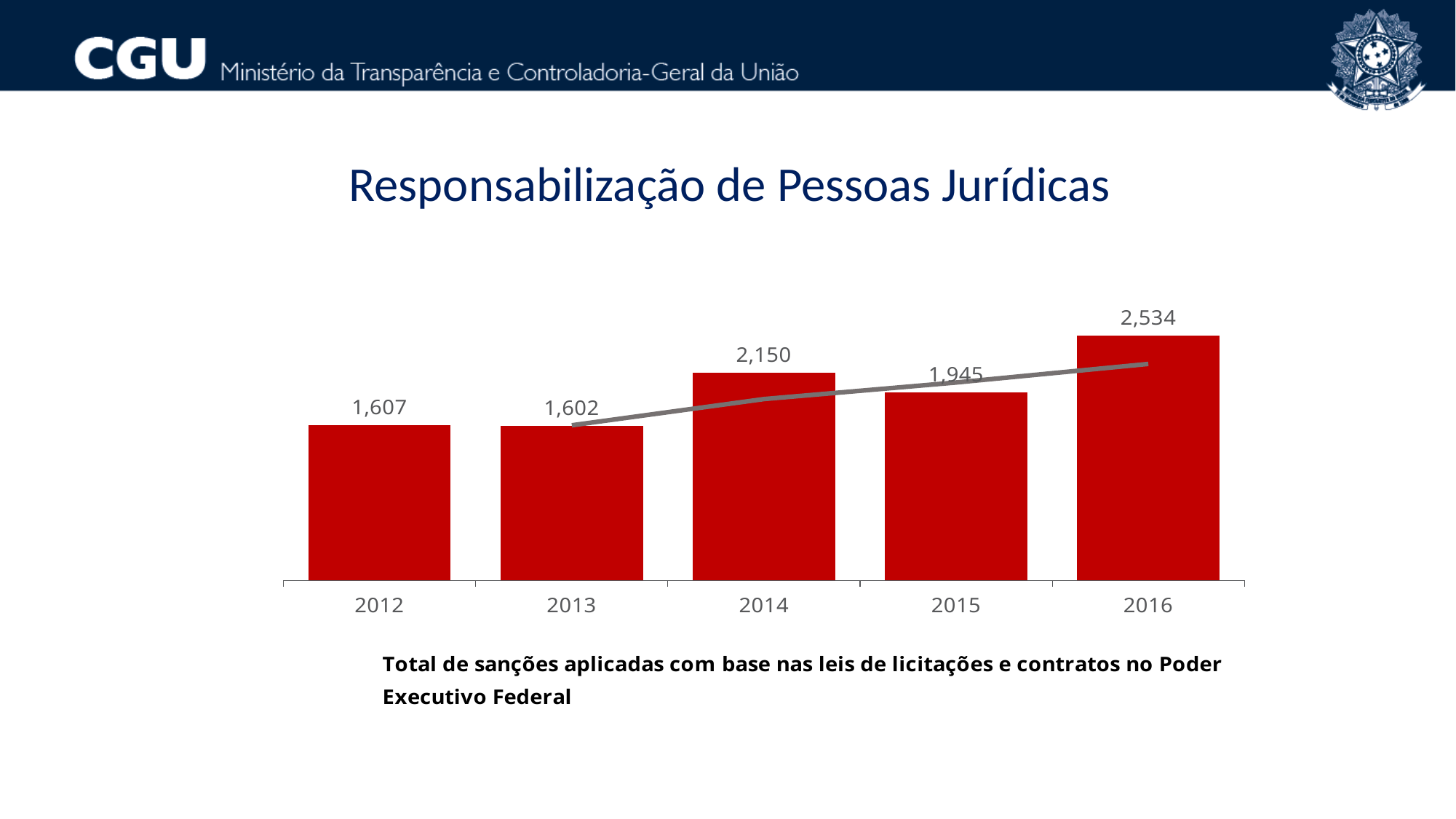
How many years are shown on the x axis? 5 What is the title of the slide containing the chart? Responsabilização de Pessoas Jurídicas What is the difference between the values for 2016 and 2015? 589 What is the value for 2016? 2,534 What is the value for 2014? 2,150 What kind of chart is shown on the slide? Bar chart Which is larger, the value for 2014 or the value for 2015? 2014 What is the value for 2015? 1,945 Which year has the lowest value? 2013 What is the value for 2012? 1,607 Which year has the highest value? 2016 What is the difference between the values for 2014 and 2013? 548